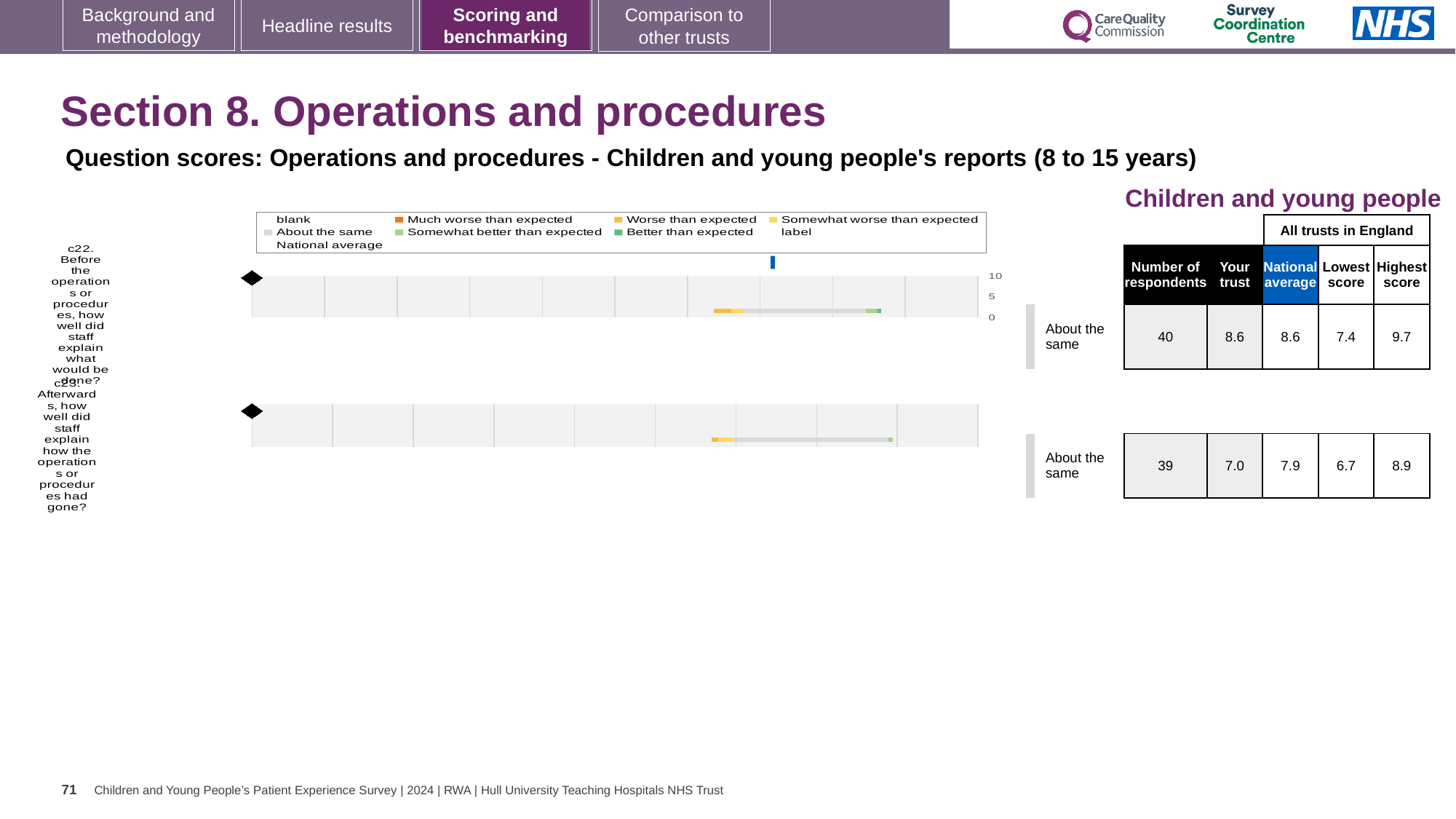
What is the difference between the national average and the trust's score for c23? 0.9 What is the national average score for c22? 8.6 What is the 'Your trust' score for c23 (Afterwards, how well did staff explain how the operations or procedures had gone?)? 7.0 What is the 'Your trust' score for c22 (Before the operations or procedures, how well did staff explain what would be done?)? 8.6 Which question has the higher 'Your trust' score, c22 or c23? c22 What is the highest score among all trusts in England for c23? 8.9 How many entries does the chart legend list? 9 How many respondents answered c22? 40 What kind of chart is used to show the question scores for c22 and c23? bar chart What is the national average score for c23? 7.9 How many questions (c22, c23) are plotted on the slide? 2 What benchmark category is shown next to the c22 chart row? About the same